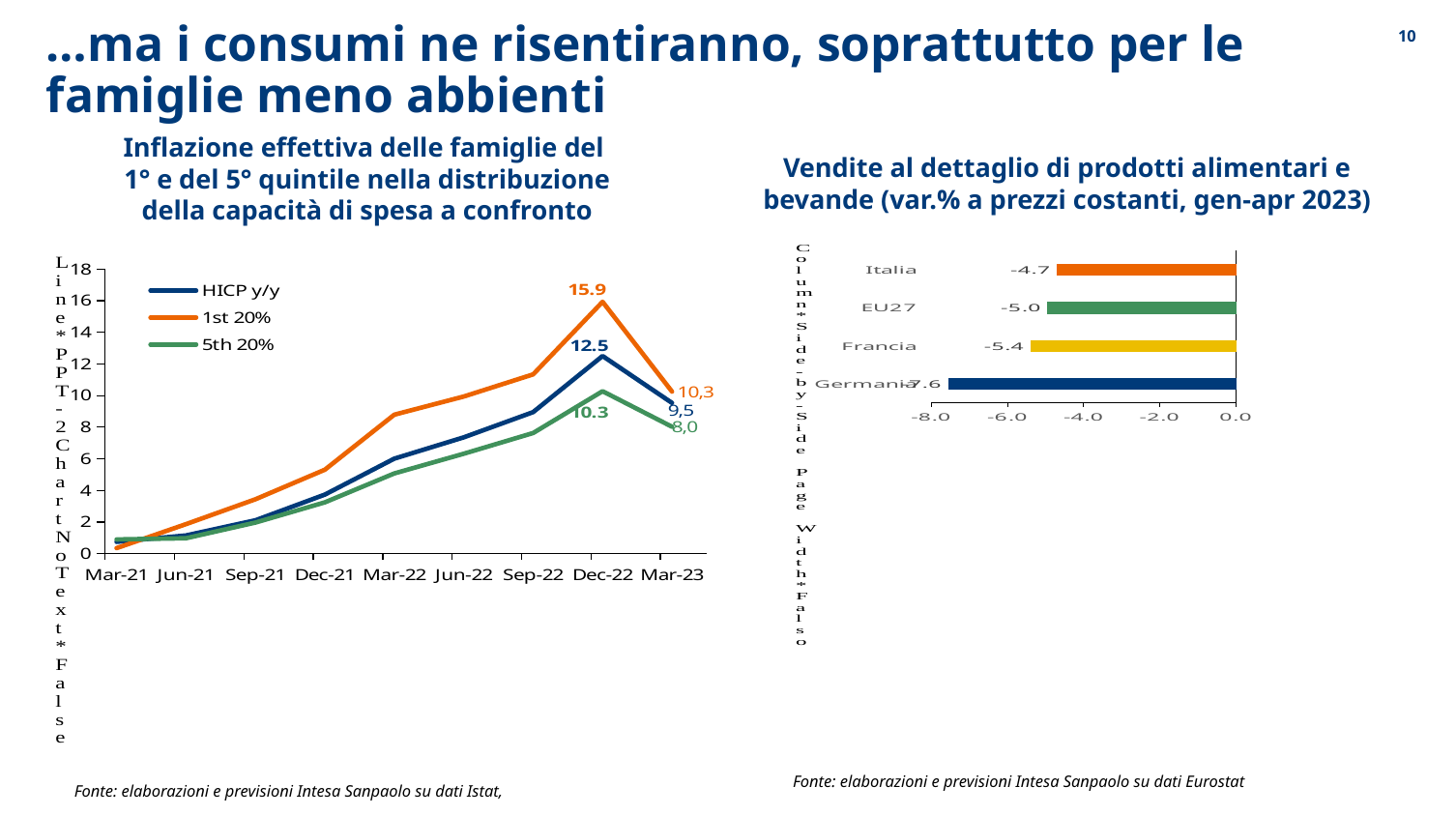
In the chart 'Inflazione effettiva delle famiglie del 1° e del 5° quintile', what is the difference between the 1st 20% and 5th 20% values at Dec-22? 5.6 In the chart 'Vendite al dettaglio di prodotti alimentari e bevande', what is the difference between the values for Italia and Germania? 2.9 In the chart 'Inflazione effettiva delle famiglie del 1° e del 5° quintile', how many points are on the x axis? 9 In the chart 'Vendite al dettaglio di prodotti alimentari e bevande', what is the value for Italia? -4.7 What kind of chart is the one on the right of the slide, 'Vendite al dettaglio di prodotti alimentari e bevande'? Bar chart In the chart 'Inflazione effettiva delle famiglie del 1° e del 5° quintile', does the 1st 20% series rise or fall from Mar-21 to Dec-22? Rise In the chart 'Vendite al dettaglio di prodotti alimentari e bevande', how many categories are shown? 4 In the chart 'Vendite al dettaglio di prodotti alimentari e bevande', what is the value for Germania? -7.6 In the chart 'Inflazione effettiva delle famiglie del 1° e del 5° quintile', what is the value of the 1st 20% series at Dec-22? 15.9 In the chart 'Inflazione effettiva delle famiglie del 1° e del 5° quintile', what is the value of the HICP y/y series at Mar-23? 9,5 In the chart 'Inflazione effettiva delle famiglie del 1° e del 5° quintile', how many series does the legend list? 3 In the chart 'Vendite al dettaglio di prodotti alimentari e bevande', which country has the lowest value? Germania